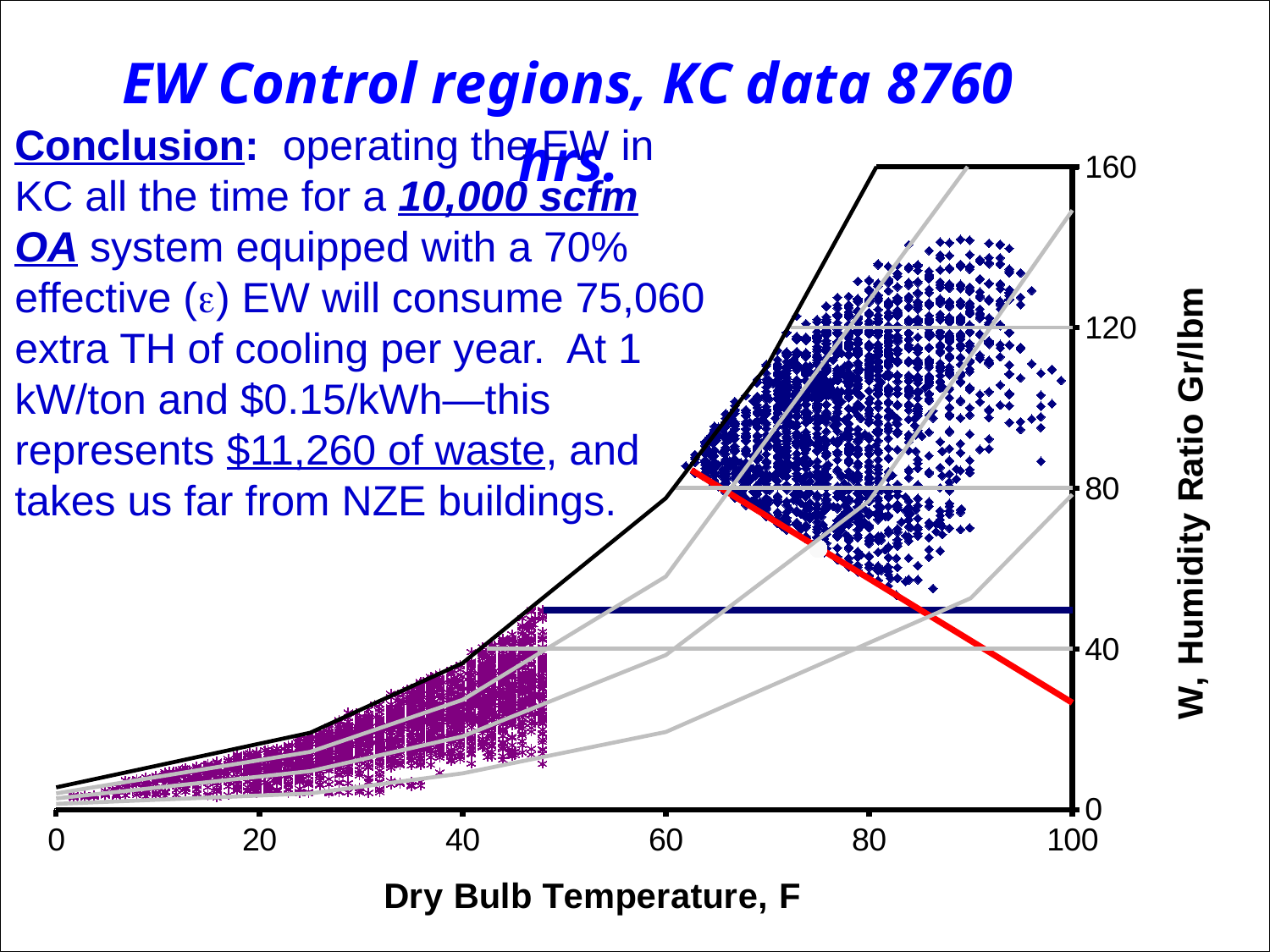
What is the label of the horizontal axis of the chart? Dry Bulb Temperature, F Does the red line rise or fall as dry bulb temperature increases from 60 F to 100 F? fall Which cluster of points reaches higher humidity ratios, the purple cluster or the blue cluster? the blue cluster Is the humidity ratio of the horizontal navy line greater or less than 40? greater Is the humidity ratio where the red line ends at 100 F greater or less than 40? less What is the title of the chart on the slide? EW Control regions, KC data 8760 hrs. What is the highest value shown on the horizontal axis (Dry Bulb Temperature, F)? 100 Is the humidity ratio of the horizontal navy line greater or less than 80? less What kind of chart is shown on the slide? scatter chart What is the highest value shown on the vertical axis (W, Humidity Ratio Gr/lbm)? 160